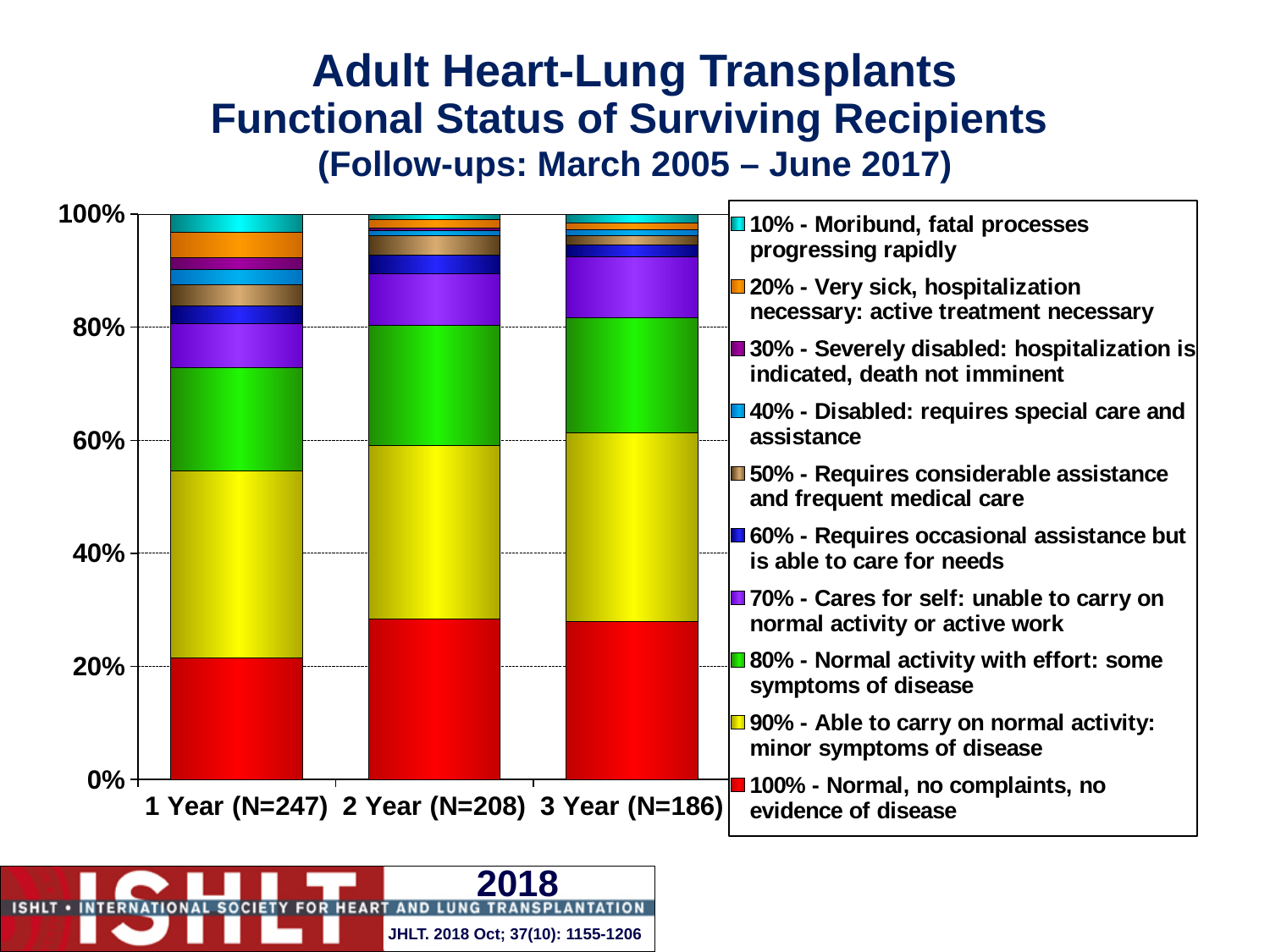
Is the share of recipients at 100% - Normal, no complaints (red segment) for 2 Year greater or less than 20%? greater Is the cumulative share of recipients at 70% functional status or better (top of the purple segment) for 2 Year greater or less than 80%? greater Which legend entry corresponds to the red segment at the bottom of each bar? 100% - Normal, no complaints, no evidence of disease How many follow-up time categories are shown on the x axis? 3 What kind of chart is shown on the slide? Stacked bar chart What does each stacked bar total? 100% Is the share of recipients at 100% - Normal, no complaints (red segment) for 2 Year greater or less than 40%? less What is the N for the 2 Year follow-up category? 208 How many series does the legend list? 10 Which has the larger red (100% - Normal, no complaints) segment: 1 Year or 2 Year? 2 Year